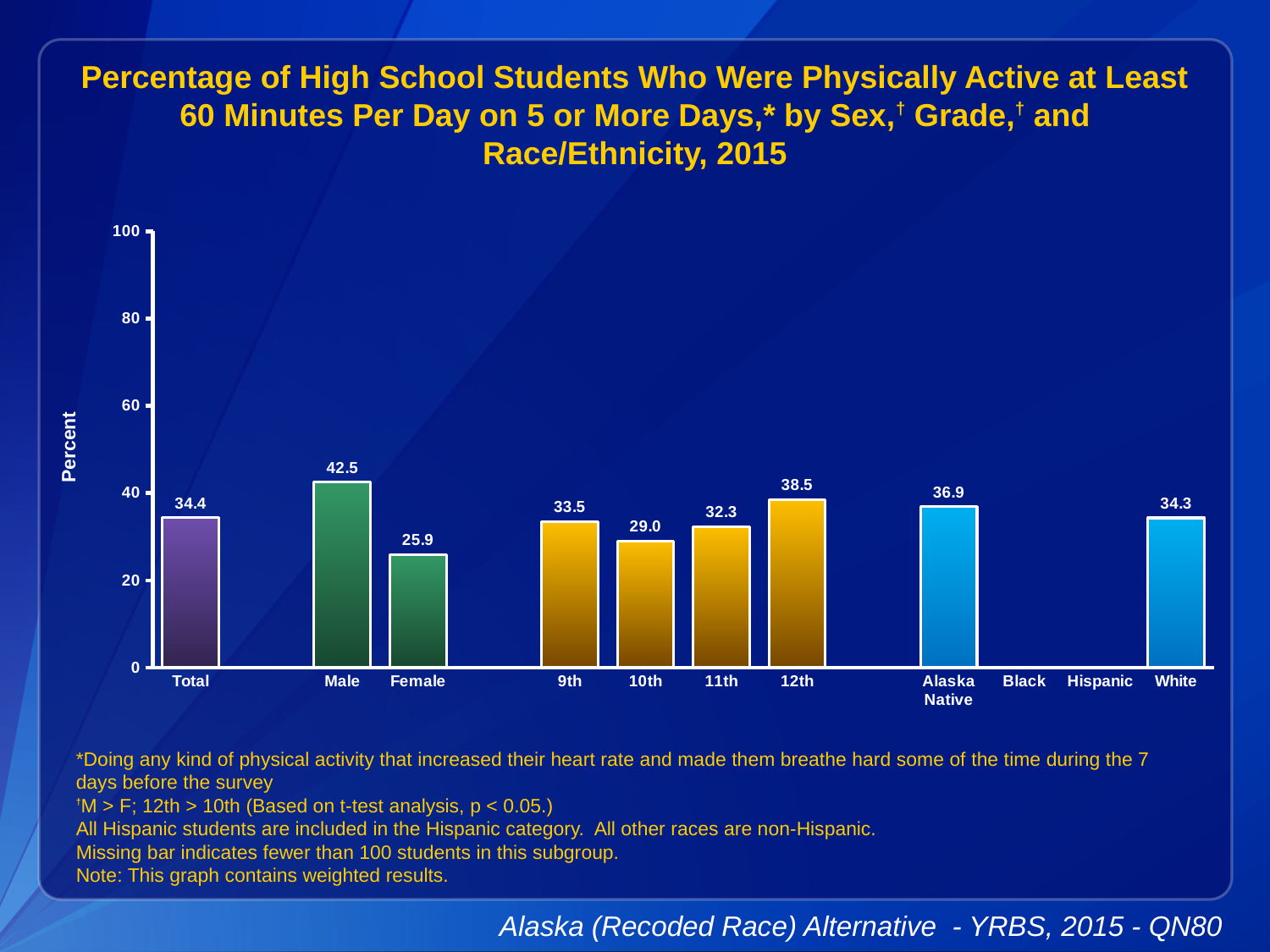
What is the value for Alaska Native? 36.9 What is the difference between the 12th grade and 10th grade values? 9.5 What kind of chart is shown on the slide? bar chart What is the difference between the Male and Female values? 16.6 What is the value for Female? 25.9 What is the value for Male? 42.5 Which category has the highest value? Male Which category has the lowest value among the bars shown? Female What is the value for 10th grade? 29.0 Is the value for Total greater or less than 40? less How many bars are plotted on the chart? 9 Which is larger, the value for 9th grade or the value for 11th grade? 9th